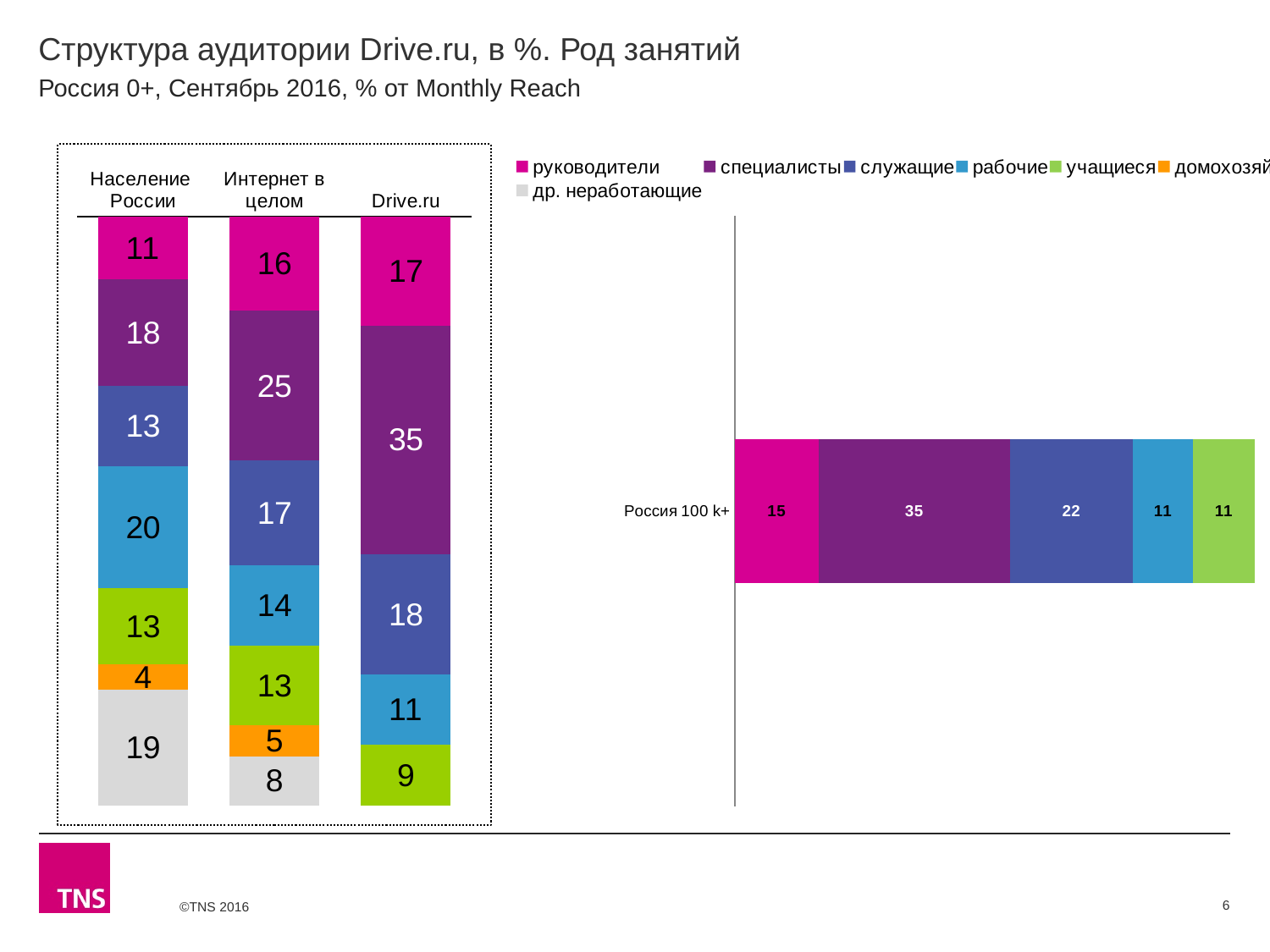
In the left chart, what is the value for др. неработающие in the Население России bar? 19 In the left chart, which segment of the Drive.ru bar is the largest? специалисты In the left chart, what is the difference between the специалисты values for Drive.ru and Население России? 17 In the left chart, which is larger: рабочие for Население России or рабочие for Drive.ru? Население России In the right chart, what is the total of the Россия 100 k+ stacked bar? 94 What kind of chart is the right chart? stacked bar chart How many series does the legend list? 7 In the left chart, which segment of the Население России bar is the smallest? домохозяйки In the right chart, what is the value for служащие in the Россия 100 k+ bar? 22 In the left chart, what is the value for служащие in the Интернет в целом bar? 17 How many bars does the left chart show? 3 In the left chart, what is the value for специалисты in the Drive.ru bar? 35